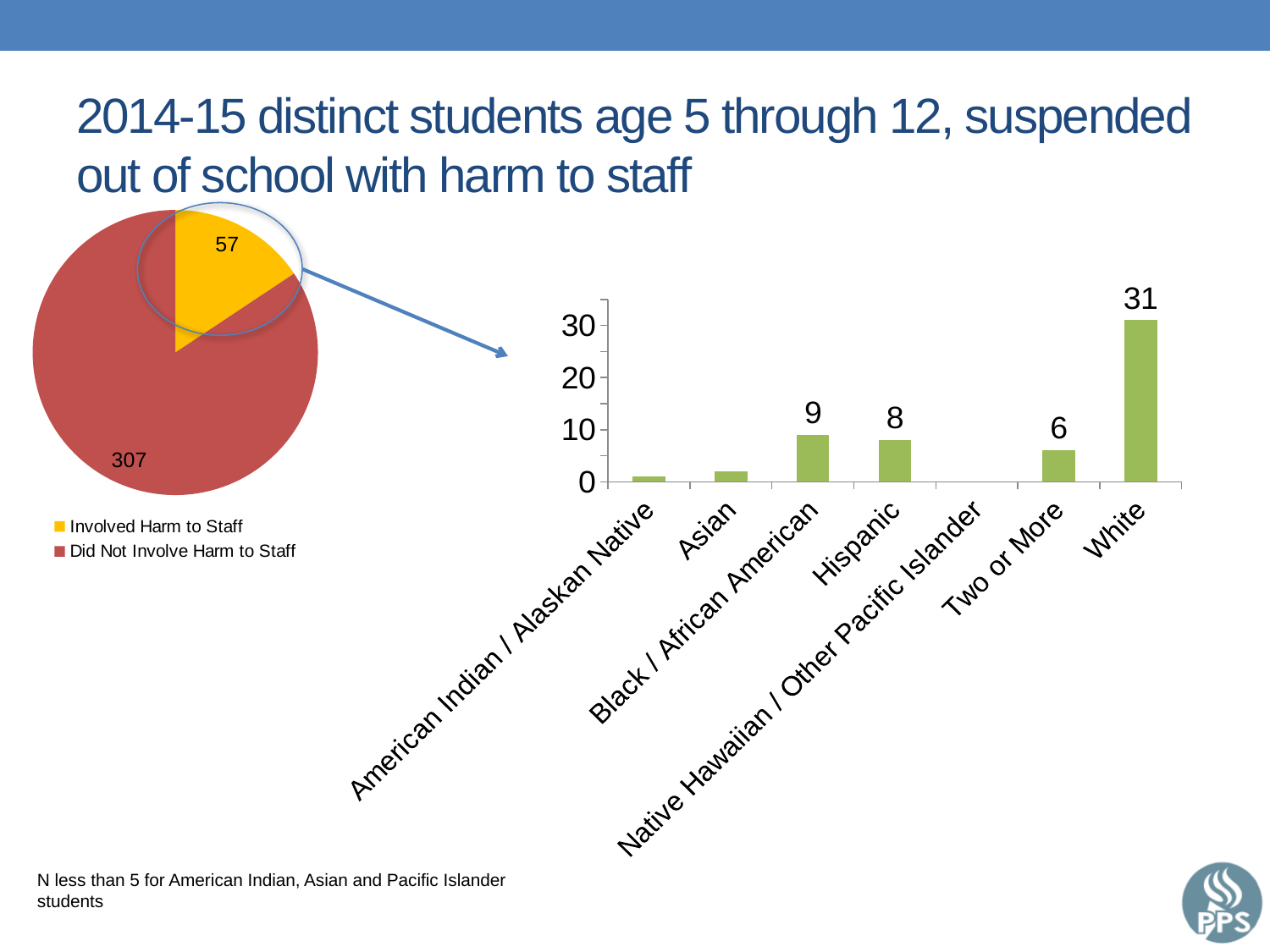
In the bar chart on the right, how many categories are shown on the x axis? 7 In the bar chart on the right, what is the value for Two or More? 6 In the pie chart on the left, what is the value for Involved Harm to Staff? 57 In the bar chart on the right, what is the difference between the values for White and Black / African American? 22 In the bar chart on the right, what is the value for Black / African American? 9 In the pie chart on the left, what colour is the Involved Harm to Staff slice? Yellow In the pie chart on the left, which slice is larger, Involved Harm to Staff or Did Not Involve Harm to Staff? Did Not Involve Harm to Staff In the pie chart on the left, what is the value for Did Not Involve Harm to Staff? 307 In the bar chart on the right, what is the value for White? 31 In the bar chart on the right, what is the value for Hispanic? 8 In the pie chart on the left, how many slices does the legend list? 2 In the bar chart on the right, which category has the highest value? White